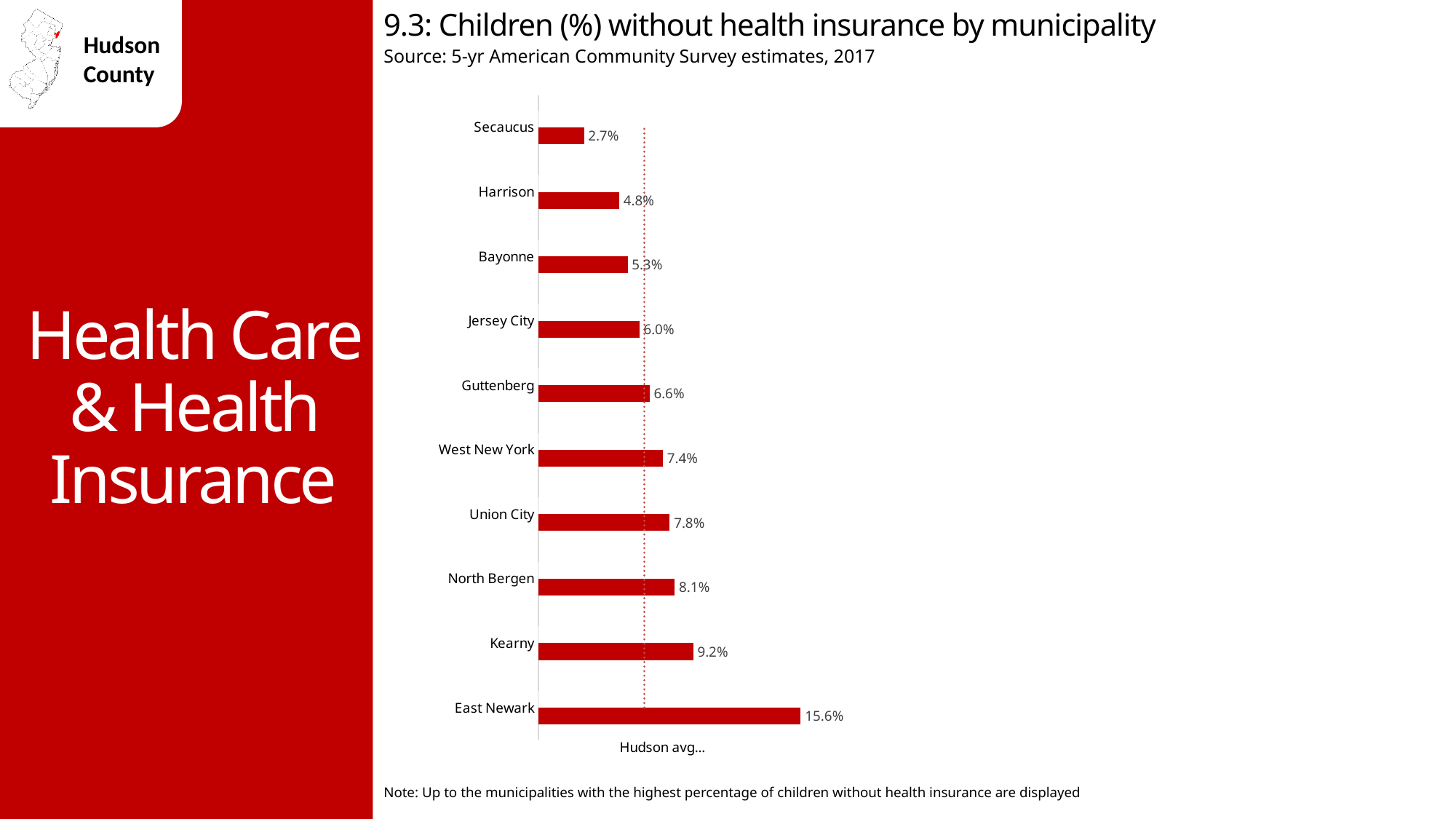
What is the difference between the values for East Newark and Kearny? 6.4% What is the value shown for Jersey City? 6.0% What does the dotted vertical line in the chart represent? Hudson avg. Which municipality has the highest percentage of children without health insurance? East Newark What is the difference between the values for Harrison and Secaucus? 2.1% Which municipality has the lowest percentage of children without health insurance? Secaucus Which has a higher value, Union City or Guttenberg? Union City How many municipalities are shown in the chart? 10 What percentage is shown for Kearny? 9.2% What percentage of children in East Newark are without health insurance? 15.6% What is the title of the chart? 9.3: Children (%) without health insurance by municipality What kind of chart is shown on the slide? Bar chart